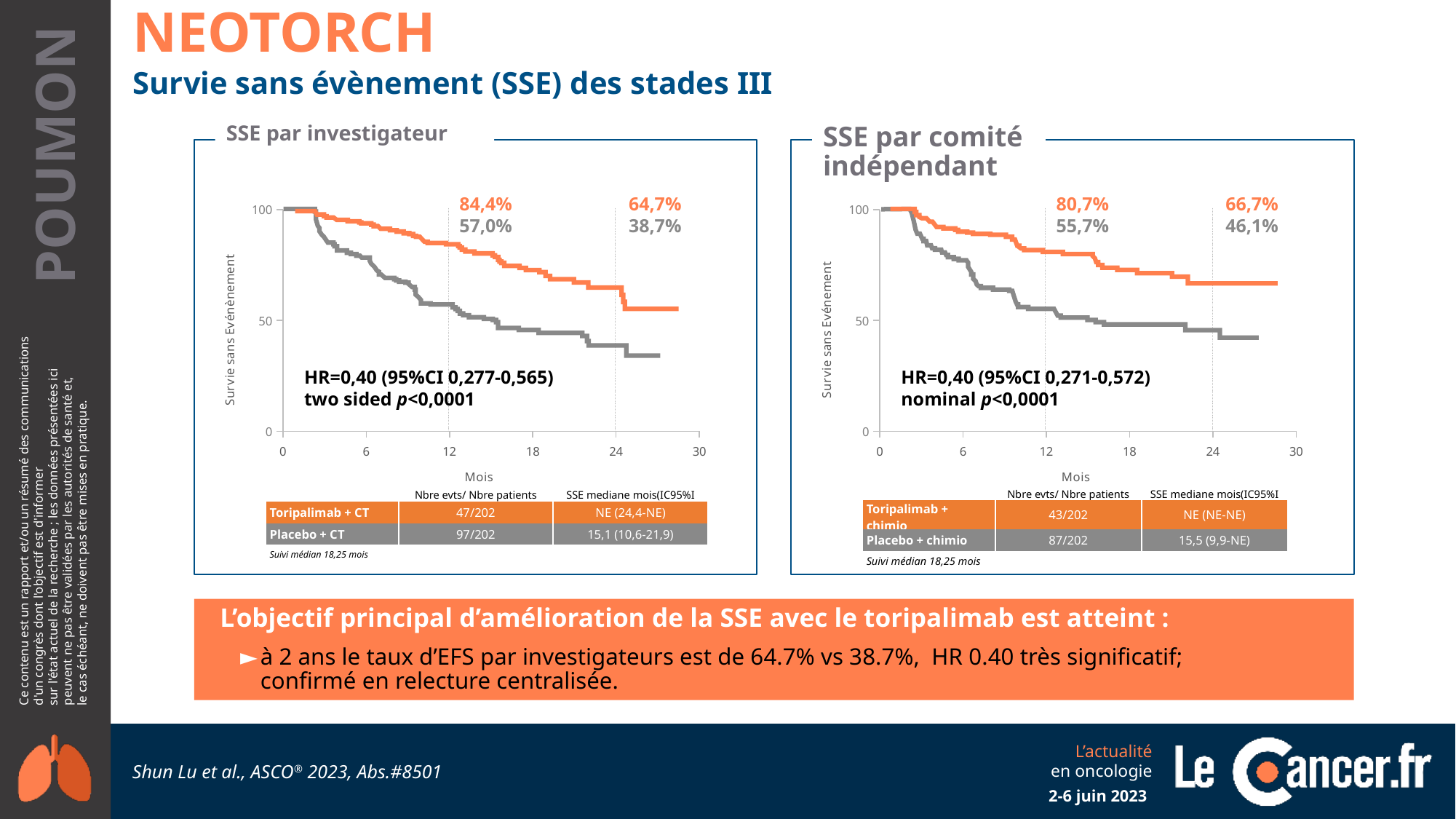
In the 'SSE par comité indépendant' chart, what is the difference between the 24-month rates printed for the orange and grey curves (66,7% and 46,1%)? 20,6% In the 'SSE par investigateur' chart, what is the difference between the 24-month rates printed for the orange and grey curves (64,7% and 38,7%)? 26,0% In the 'SSE par comité indépendant' chart, how many events / patients are listed for Toripalimab + chimio? 43/202 In the 'SSE par investigateur' chart, what median SSE (months) is listed in the table for Placebo + CT? 15,1 (10,6-21,9) In the 'SSE par investigateur' chart, what event-free survival rate is printed for the orange (Toripalimab + CT) curve at 24 months? 64,7% What kind of chart is used in the 'SSE par investigateur' panel? Line chart (Kaplan-Meier survival curve) In the 'SSE par investigateur' chart, what event-free survival rate is printed for the grey (Placebo + CT) curve at 24 months? 38,7% In the 'SSE par comité indépendant' chart, what rate is printed for the grey (Placebo + chimio) curve at 12 months? 55,7% In the 'SSE par investigateur' chart, is the orange curve at 18 months greater or less than 50? greater In the 'SSE par comité indépendant' chart, what rate is printed for the orange (Toripalimab + chimio) curve at 24 months? 66,7% In the 'SSE par comité indépendant' chart, do the survival curves rise or fall as months increase? Fall In the 'SSE par investigateur' chart, which arm has the higher event-free survival at 24 months, Toripalimab + CT or Placebo + CT? Toripalimab + CT